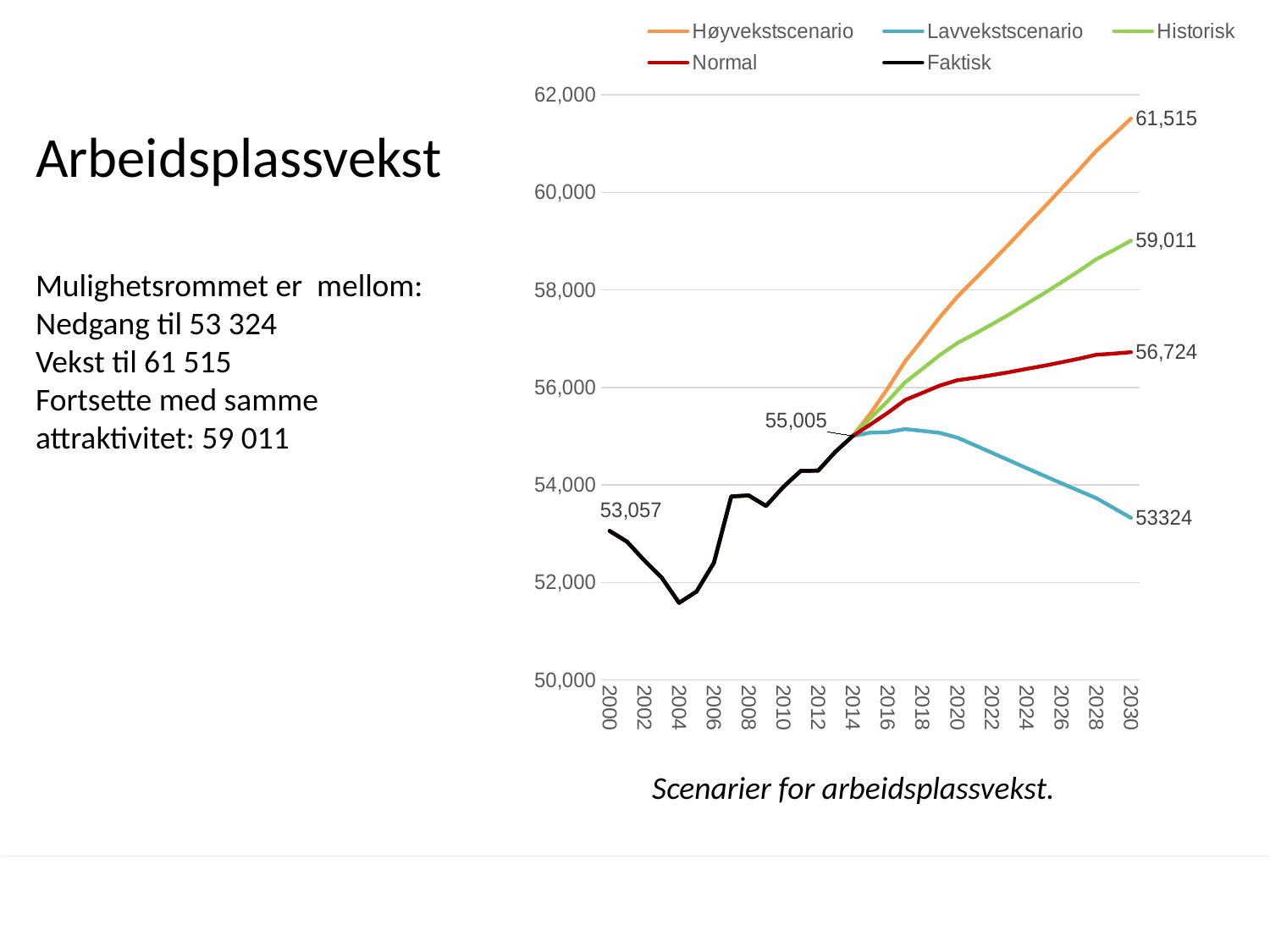
What is the difference between the Høyvekstscenario and Lavvekstscenario values in 2030? 8,191 How many series does the chart legend list? 5 What value does the Høyvekstscenario line reach in 2030? 61,515 What value does the Normal line reach in 2030? 56,724 What kind of chart is shown on the slide? line chart What is the labelled value where the scenario lines branch off in 2014? 55,005 Which series has the lowest value in 2030? Lavvekstscenario Which series has the highest value in 2030? Høyvekstscenario What is the labelled value of the Faktisk line in 2000? 53,057 Is the Faktisk value in 2004 greater or less than 52,000? less What value does the Lavvekstscenario line reach in 2030? 53324 What value does the Historisk line reach in 2030? 59,011